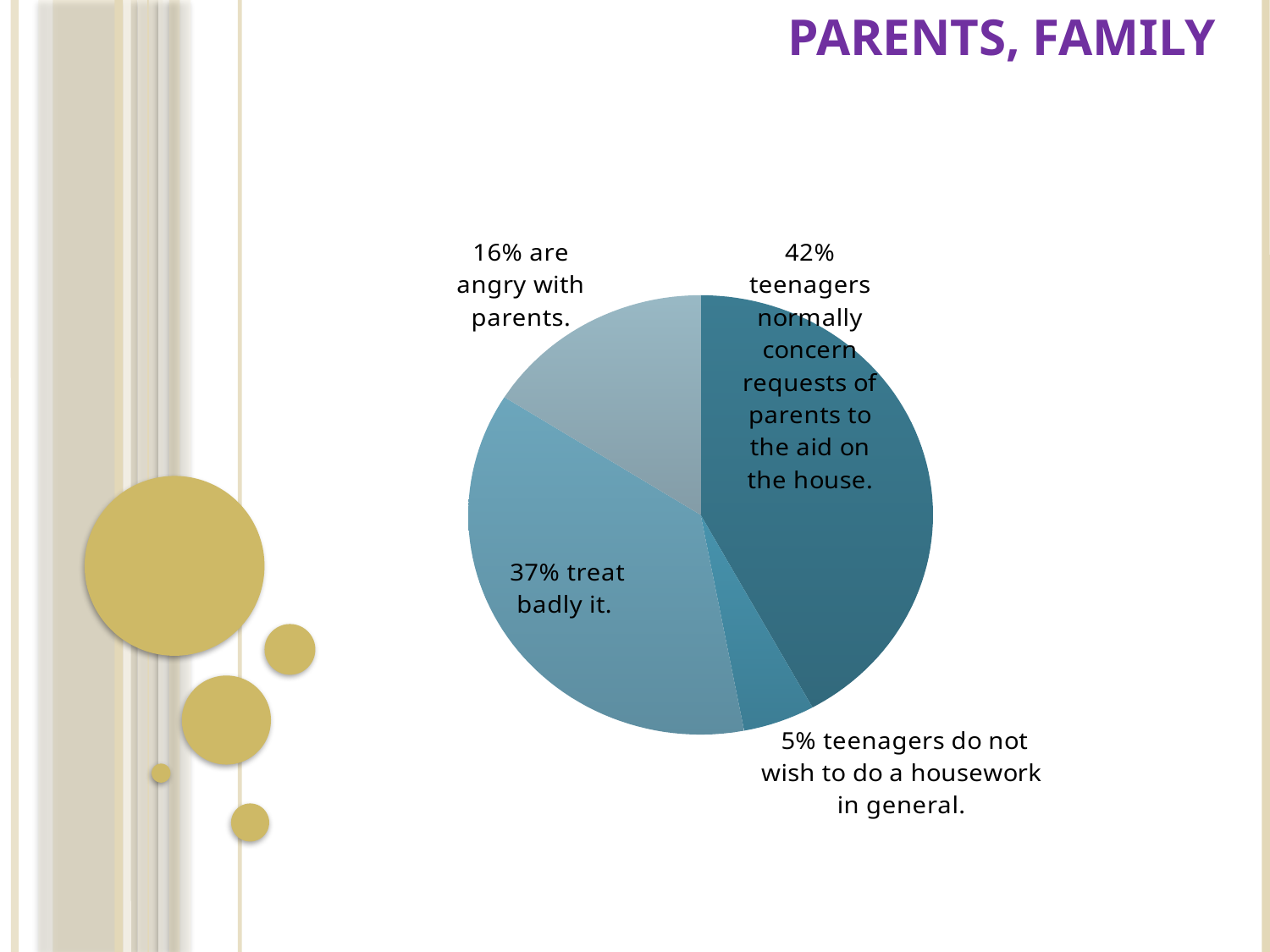
What percentage of teenagers do not wish to do a housework in general? 5% What type of chart is shown on the slide? pie chart What is the difference between the share of teenagers who normally concern requests of parents and the share who treat badly it? 5% Which slice of the pie chart is the largest? 42% teenagers normally concern requests of parents to the aid on the house What is the title of the slide containing the pie chart? PARENTS, FAMILY What percentage of teenagers treat badly the requests of parents? 37% What percentage of teenagers normally concern requests of parents to the aid on the house? 42% Which slice of the pie chart is the smallest? 5% teenagers do not wish to do a housework in general What is the combined share of teenagers who are angry with parents and those who do not wish to do a housework in general? 21% How many slices does the pie chart have? 4 What percentage are angry with parents? 16% Which is larger: the share who are angry with parents or the share who do not wish to do a housework in general? angry with parents (16%)